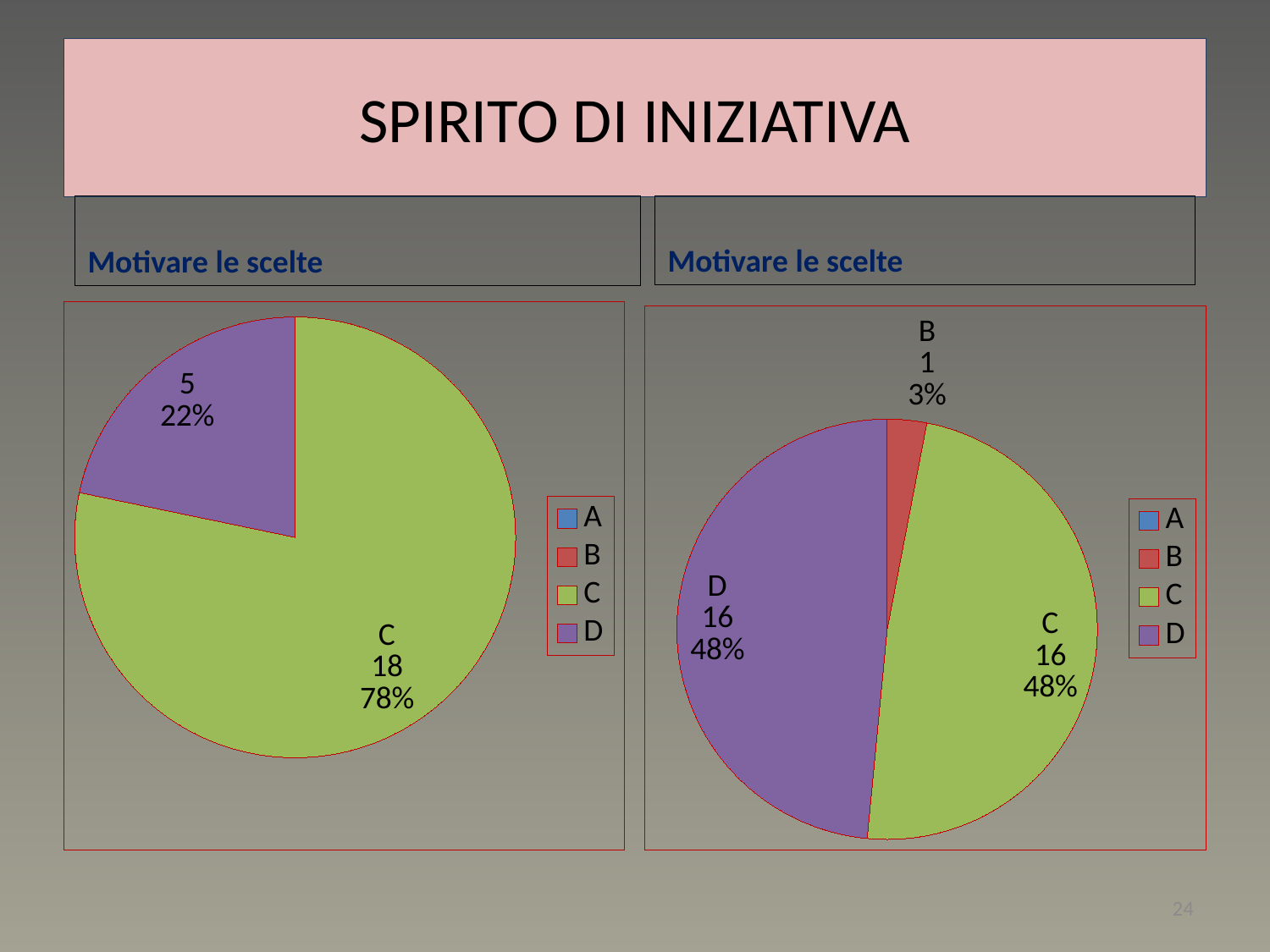
In the right pie chart, what is the difference between the value for C and the value for B? 15 In the right pie chart, which category has the smallest slice? B In the left pie chart, what percentage share does the purple slice (D) have? 22% In the right pie chart, what value is shown for category B? 1 What is the title shown above the left pie chart? Motivare le scelte In the left pie chart, what percentage share does category C have? 78% How many entries does the legend of the right pie chart list? 4 In the left pie chart, which category has the largest slice? C In the left pie chart, what is the difference between the value for C and the value for the purple slice (D)? 13 In the right pie chart, what percentage share does category D have? 48% In the left pie chart, what value is shown for category C? 18 What kind of chart is shown on the left side of the slide? pie chart